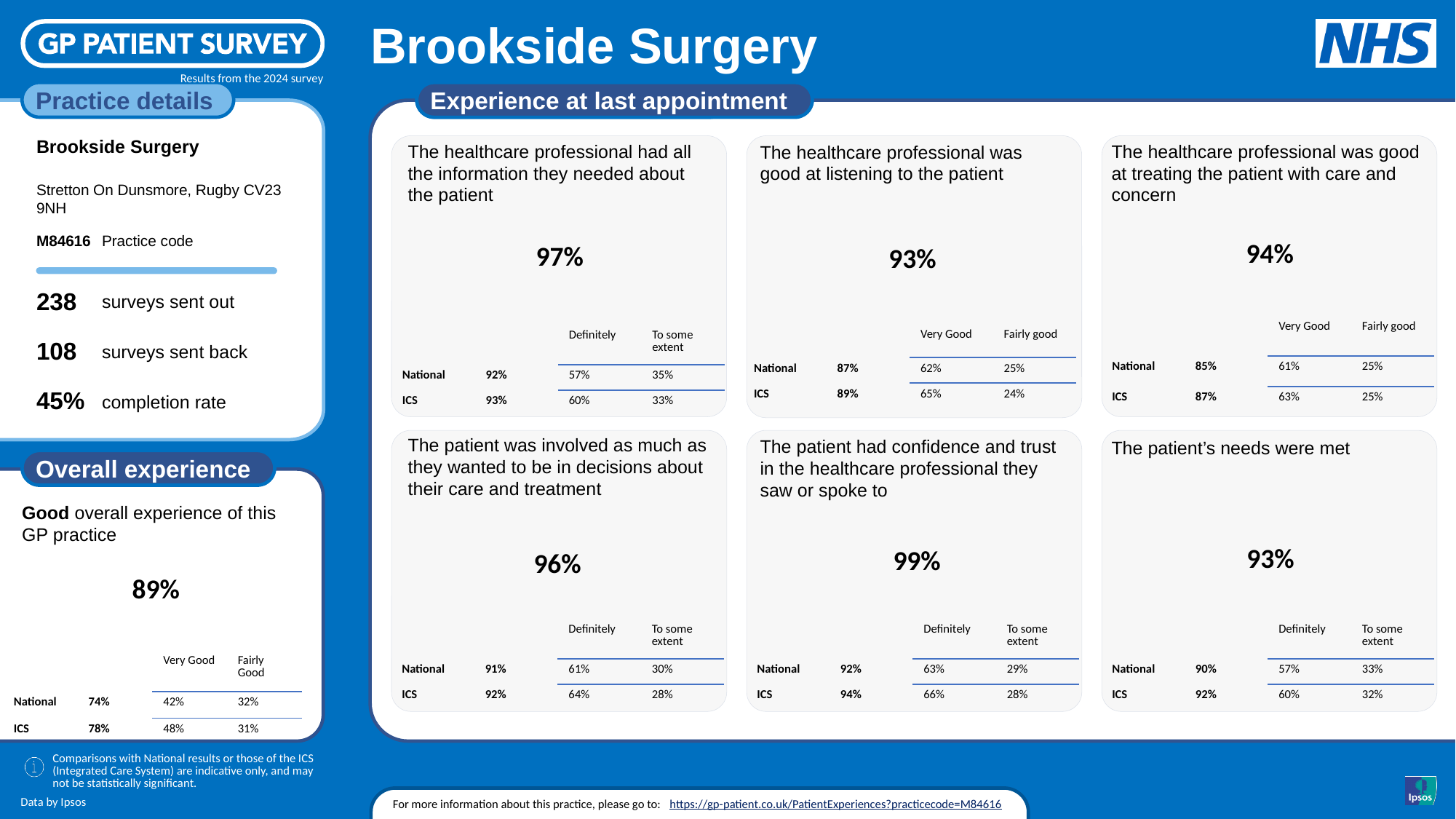
In the 'The patient's needs were met' panel, what is the difference between the practice's headline percentage and the National value? 3% In the 'The healthcare professional was good at listening to the patient' panel, what is the National 'Very Good' value? 62% In the 'The healthcare professional had all the information they needed about the patient' panel, what is the practice's headline percentage? 97% In the 'Good overall experience of this GP practice' panel, what is the National value? 74% In the 'The patient was involved as much as they wanted to be in decisions about their care and treatment' panel, which is larger, the National value or the ICS value? ICS In the 'Good overall experience of this GP practice' panel, what is the practice's headline percentage? 89% Across the six 'Experience at last appointment' panels, which question has the highest practice headline percentage? The patient had confidence and trust in the healthcare professional they saw or spoke to How many question panels are shown under the 'Experience at last appointment' heading? 6 In the 'Good overall experience of this GP practice' panel, what is the ICS 'Very Good' value? 48% Across the six 'Experience at last appointment' panels, which question has the lowest practice headline percentage? Two panels tie at 93%: 'The healthcare professional was good at listening to the patient' and 'The patient's needs were met' In the 'The patient had confidence and trust in the healthcare professional they saw or spoke to' panel, what is the practice's headline percentage? 99% In the 'The healthcare professional was good at treating the patient with care and concern' panel, what is the ICS value? 87%